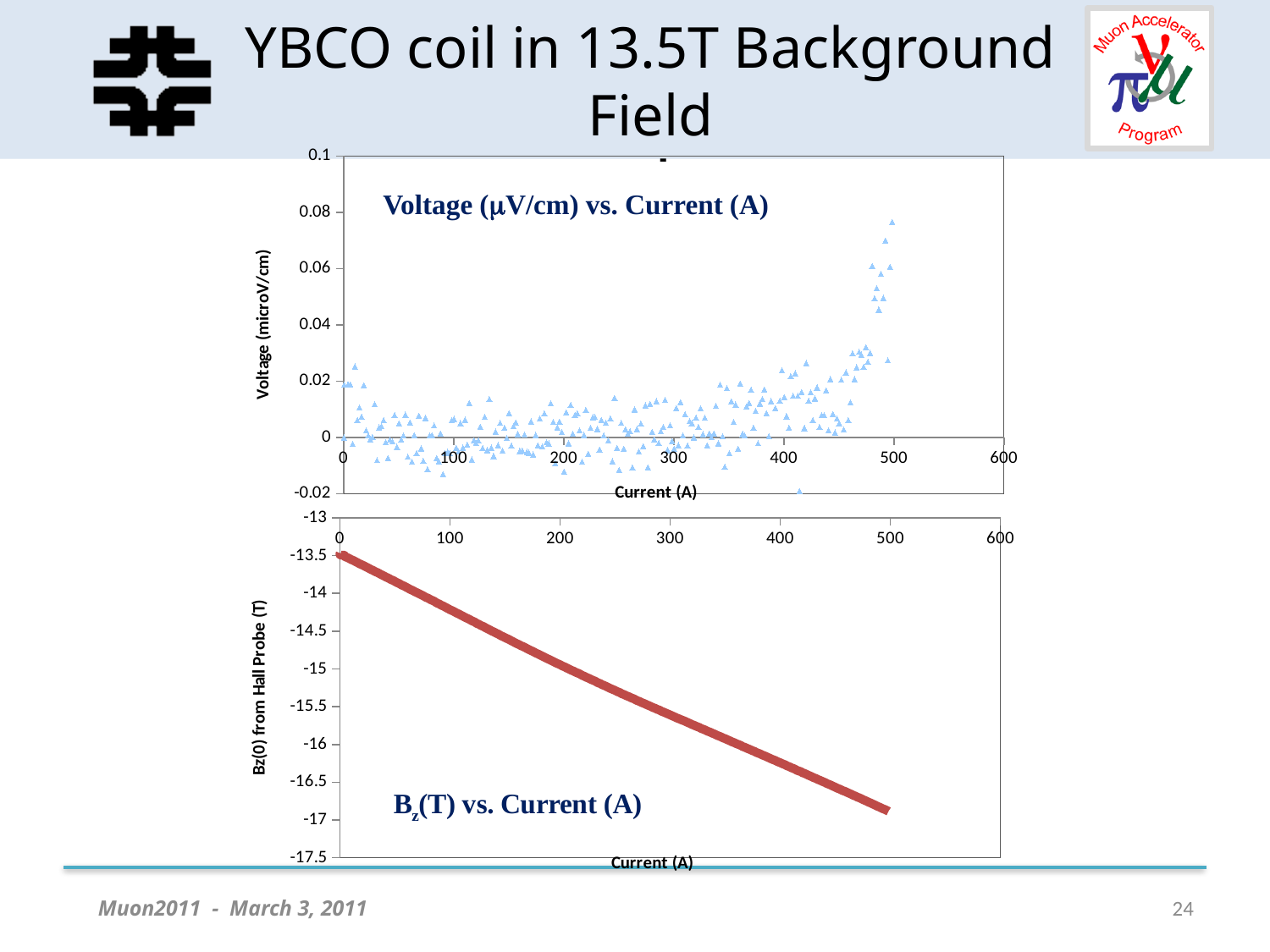
In the bottom chart 'Bz(T) vs. Current (A)', is the value of Bz at 500 A greater or less than -16.5? less What kind of chart is the bottom chart, 'Bz(T) vs. Current (A)'? line chart In the top chart 'Voltage (μV/cm) vs. Current (A)', is the highest plotted voltage greater or less than 0.06? greater In the top chart 'Voltage (μV/cm) vs. Current (A)', is the highest plotted voltage greater or less than 0.08? less In the top chart 'Voltage (μV/cm) vs. Current (A)', does the voltage rise or fall sharply as the current approaches 500 A? rise What is the y-axis title of the top chart 'Voltage (μV/cm) vs. Current (A)'? Voltage (microV/cm) What is the y-axis title of the bottom chart 'Bz(T) vs. Current (A)'? Bz(0) from Hall Probe (T) What kind of chart is the top chart, 'Voltage (μV/cm) vs. Current (A)'? scatter chart In the bottom chart 'Bz(T) vs. Current (A)', which has the larger (less negative) Bz value: 100 A or 400 A? 100 A In the bottom chart 'Bz(T) vs. Current (A)', does Bz rise or fall as the current increases from 0 to 500 A? fall